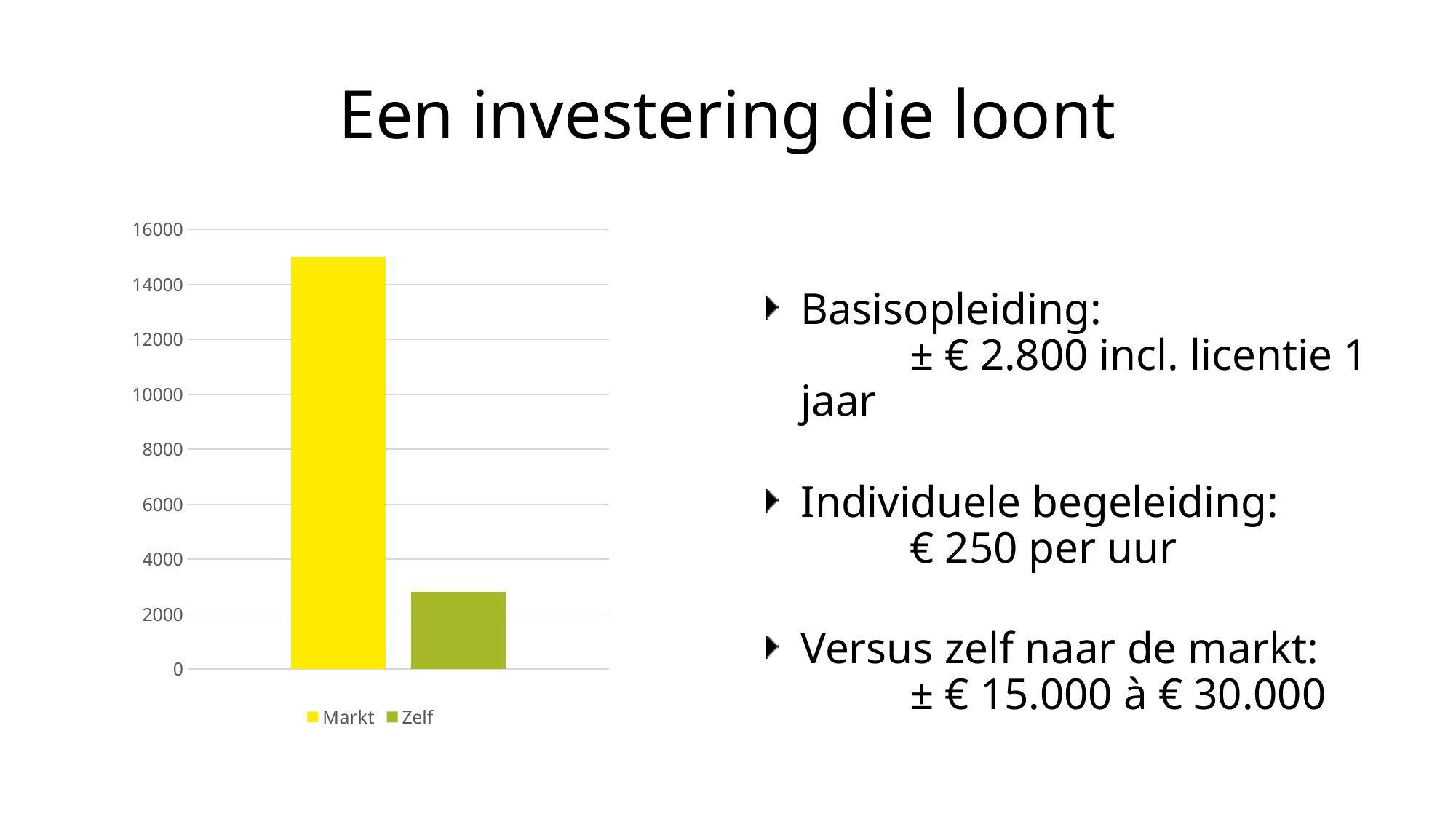
What colour is the bar for Markt in the chart? yellow Which series has the highest bar in the chart? Markt What kind of chart is shown on the slide? bar chart Is the value for Markt greater or less than 16000? less How many series does the chart legend list? 2 What are the two entries listed in the chart legend? Markt and Zelf Is the value for Markt greater or less than 14000? greater Is the value for Zelf greater or less than 2000? greater Which is larger in the chart, the value for Markt or the value for Zelf? Markt Which series has the lowest bar in the chart? Zelf How many bars are plotted in the chart? 2